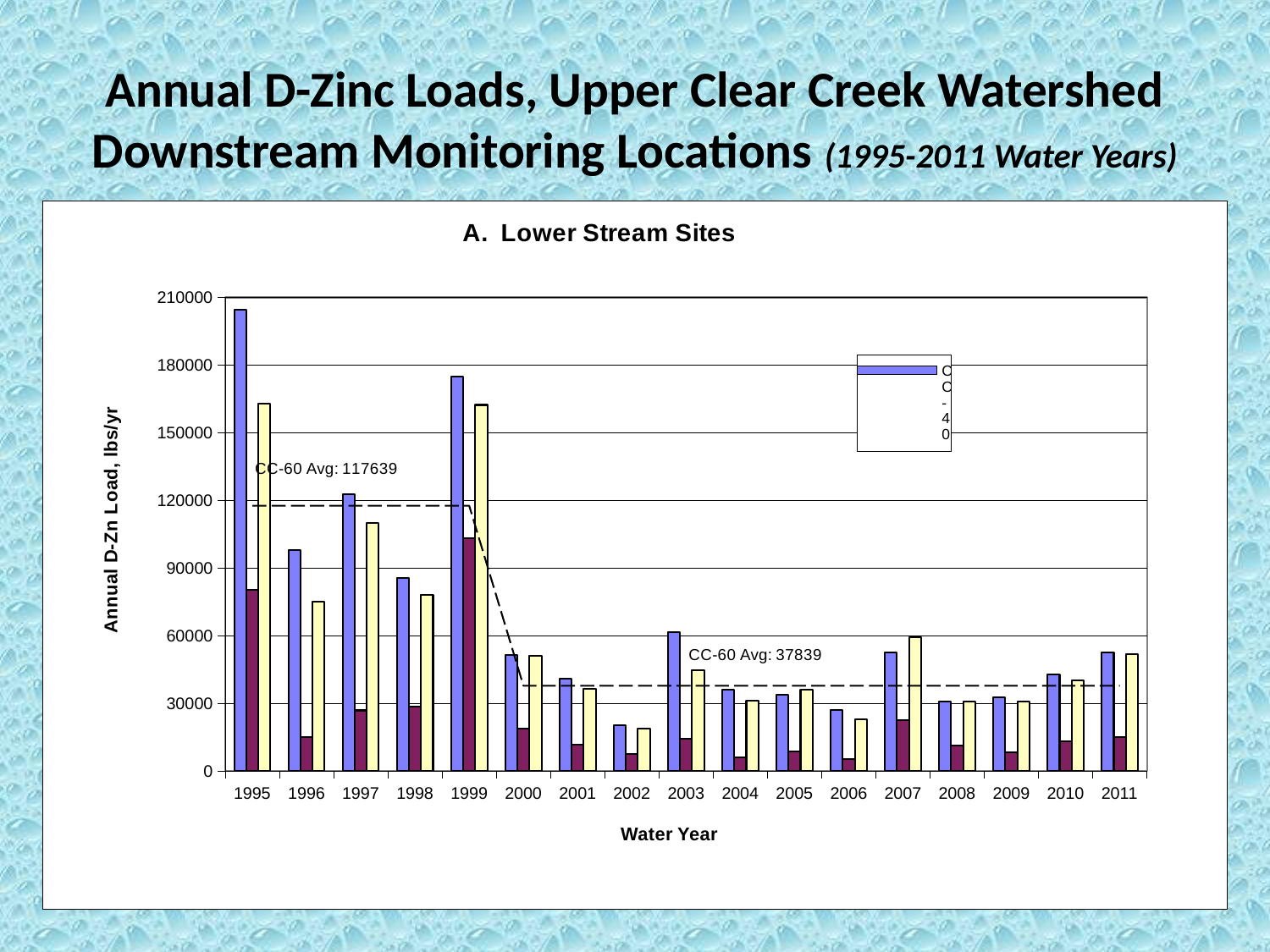
What kind of chart is shown on the slide? bar chart Which is larger, the blue bar for 1995 or the blue bar for 1999? 1995 How many bars are plotted for each water year? 3 In which water year is the purple bar the tallest? 1999 Is the blue bar for 1995 greater or less than 180000? greater How many water years are shown on the x axis? 17 In which water year is the blue bar the tallest? 1995 What is the label of the y axis? Annual D-Zn Load, lbs/yr Is the blue bar for 2002 greater or less than 30000? less Do the blue bars generally rise or fall from 1995 to 2002? fall In which water year is the blue bar the shortest? 2002 What is the title of the chart? A. Lower Stream Sites